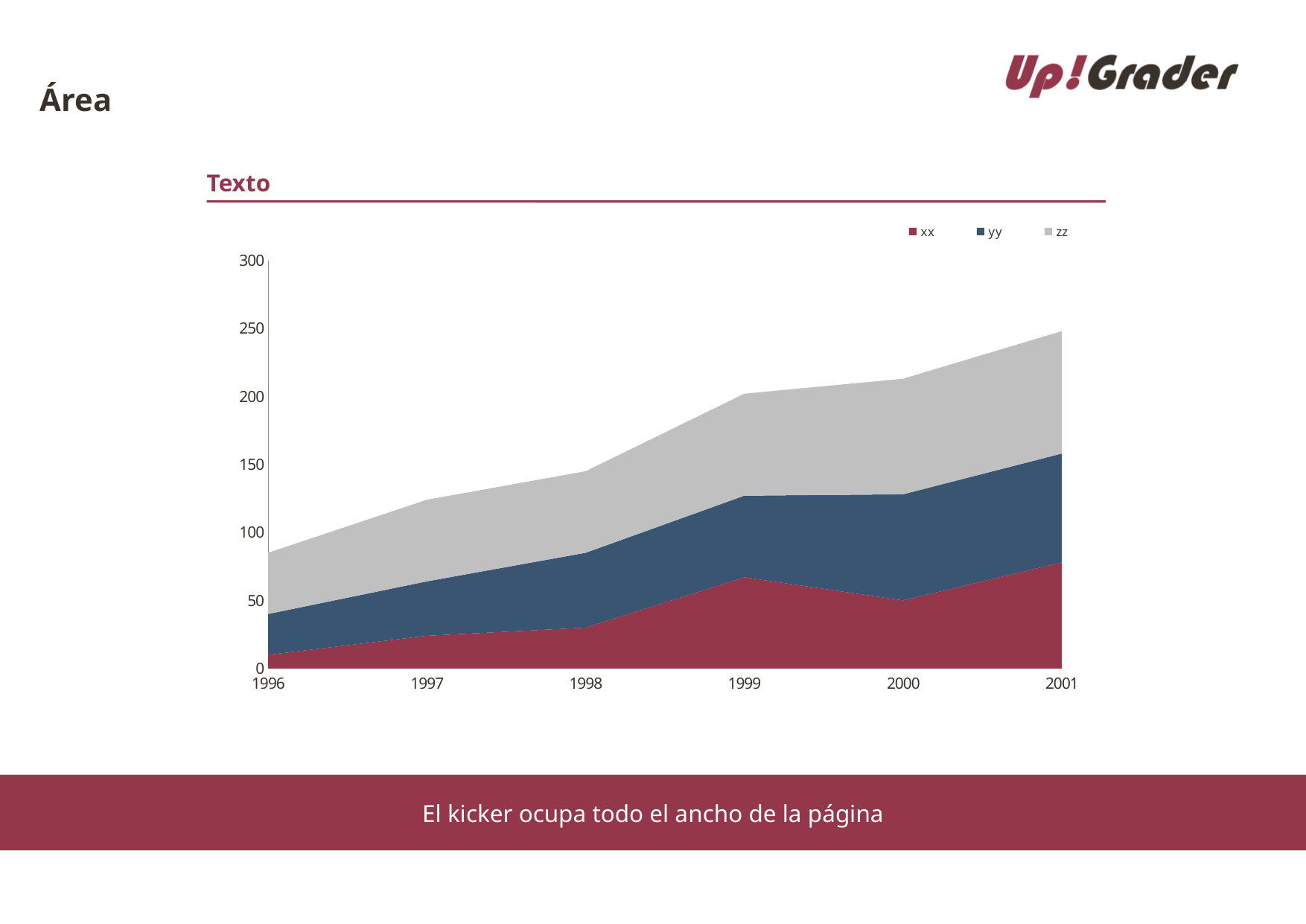
What kind of chart is shown on the slide? Stacked area chart What is the title shown above the chart? Texto Which year has a larger total stacked value, 1997 or 1999? 1999 Which year has the highest total stacked value? 2001 Is the value for series xx in 1999 greater or less than 50? greater Does the total stacked value rise or fall from 1996 to 2001? Rises Is the total stacked value for 2001 greater or less than 200? greater What are the names of the series listed in the chart legend? xx, yy, zz Which year has the lowest total stacked value? 1996 How many years are shown along the x axis of the chart? 6 Is the total stacked value for 1996 greater or less than 100? less How many series does the chart legend list? 3